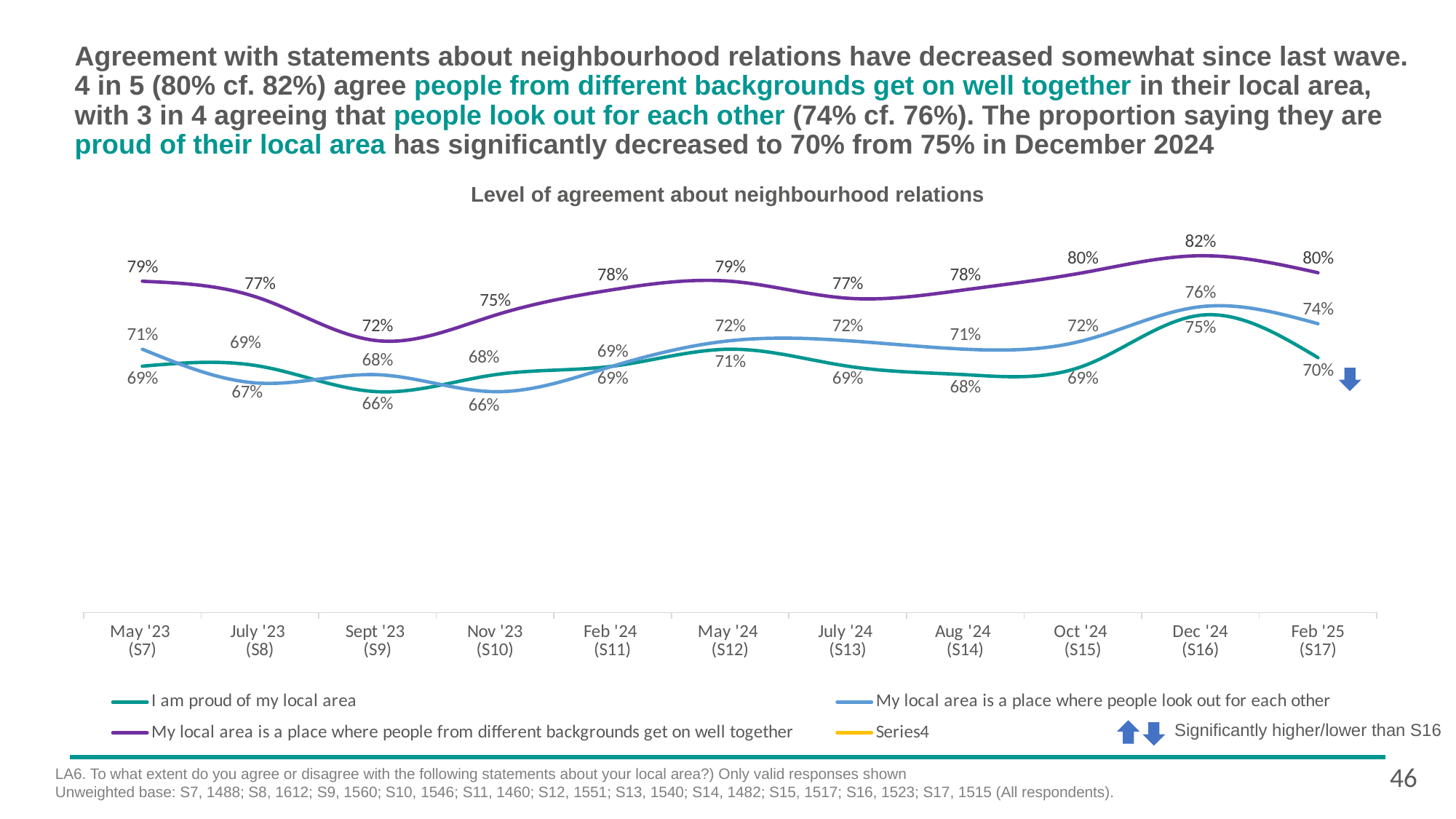
In which wave is 'My local area is a place where people from different backgrounds get on well together' at its highest? Dec '24 (S16) What is the value for 'My local area is a place where people from different backgrounds get on well together' in Dec '24 (S16)? 82% By how many percentage points did 'I am proud of my local area' fall from Dec '24 (S16) to Feb '25 (S17)? 5 percentage points In Feb '25 (S17), which is higher: 'I am proud of my local area' or 'My local area is a place where people look out for each other'? My local area is a place where people look out for each other How many survey waves (points) are plotted along the x axis? 11 What is the title of the chart? Level of agreement about neighbourhood relations What is the value for 'My local area is a place where people look out for each other' in Feb '25 (S17)? 74% What kind of chart is shown on the slide? Line chart In which wave is 'My local area is a place where people from different backgrounds get on well together' at its lowest? Sept '23 (S9) What is the value for 'I am proud of my local area' in Feb '25 (S17)? 70% How many series does the legend list? 4 What is the value for 'I am proud of my local area' in Sept '23 (S9)? 66%